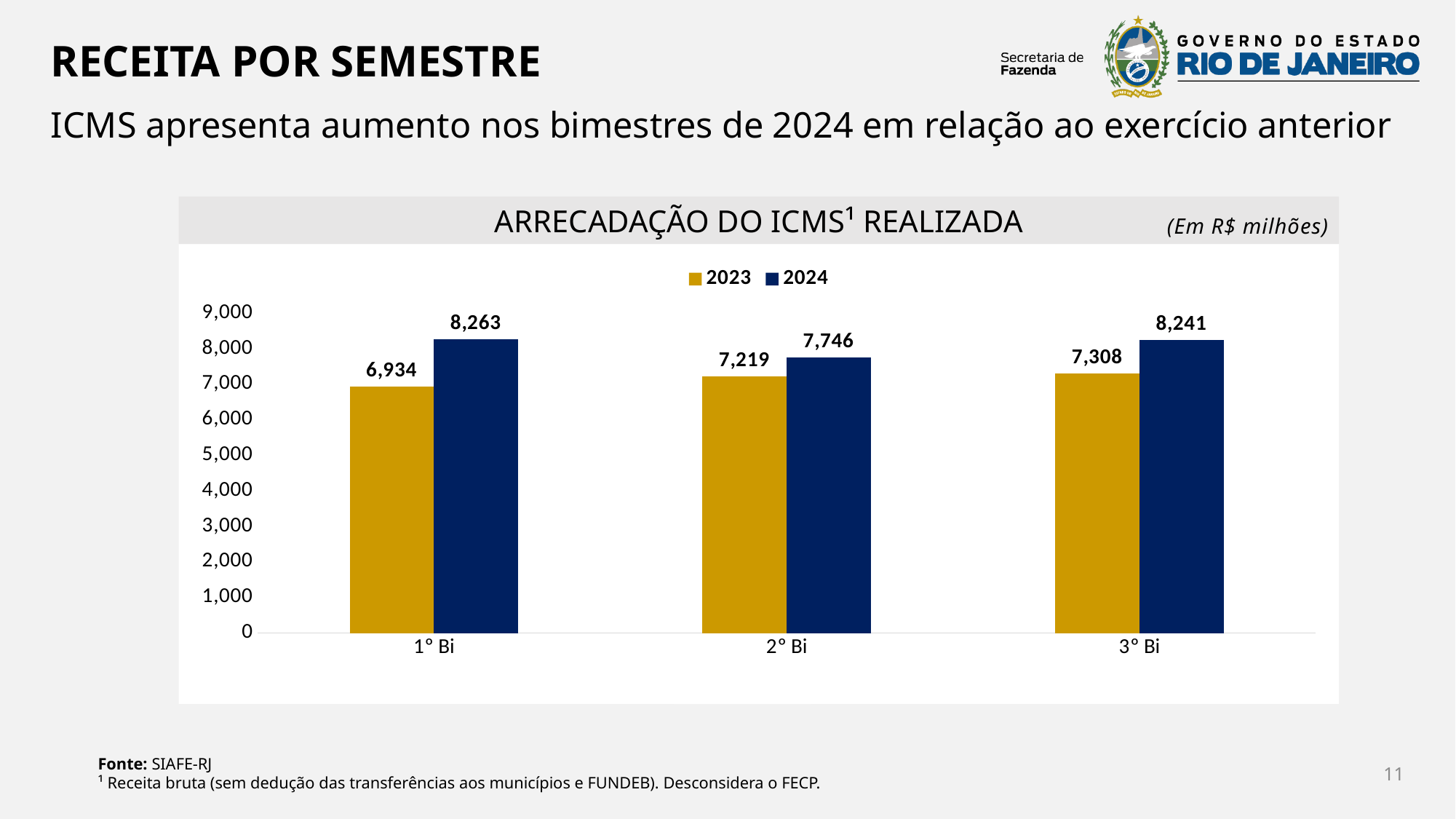
How many bimesters are shown on the x axis? 3 How many series does the legend list? 2 What is the difference between the 2024 and 2023 values for 1° Bi? 1,329 Which bimester has the lowest 2024 value? 2° Bi What is the 2024 value for 3° Bi? 8,241 What kind of chart is shown? bar chart Which is larger for 2° Bi, the 2023 value or the 2024 value? 2024 Is the 2023 value for 1° Bi greater or less than 7,000? less What is the difference between the 2024 and 2023 values for 3° Bi? 933 What is the 2023 value for 2° Bi? 7,219 What is the 2024 value for 1° Bi? 8,263 Which bimester has the highest 2023 value? 3° Bi